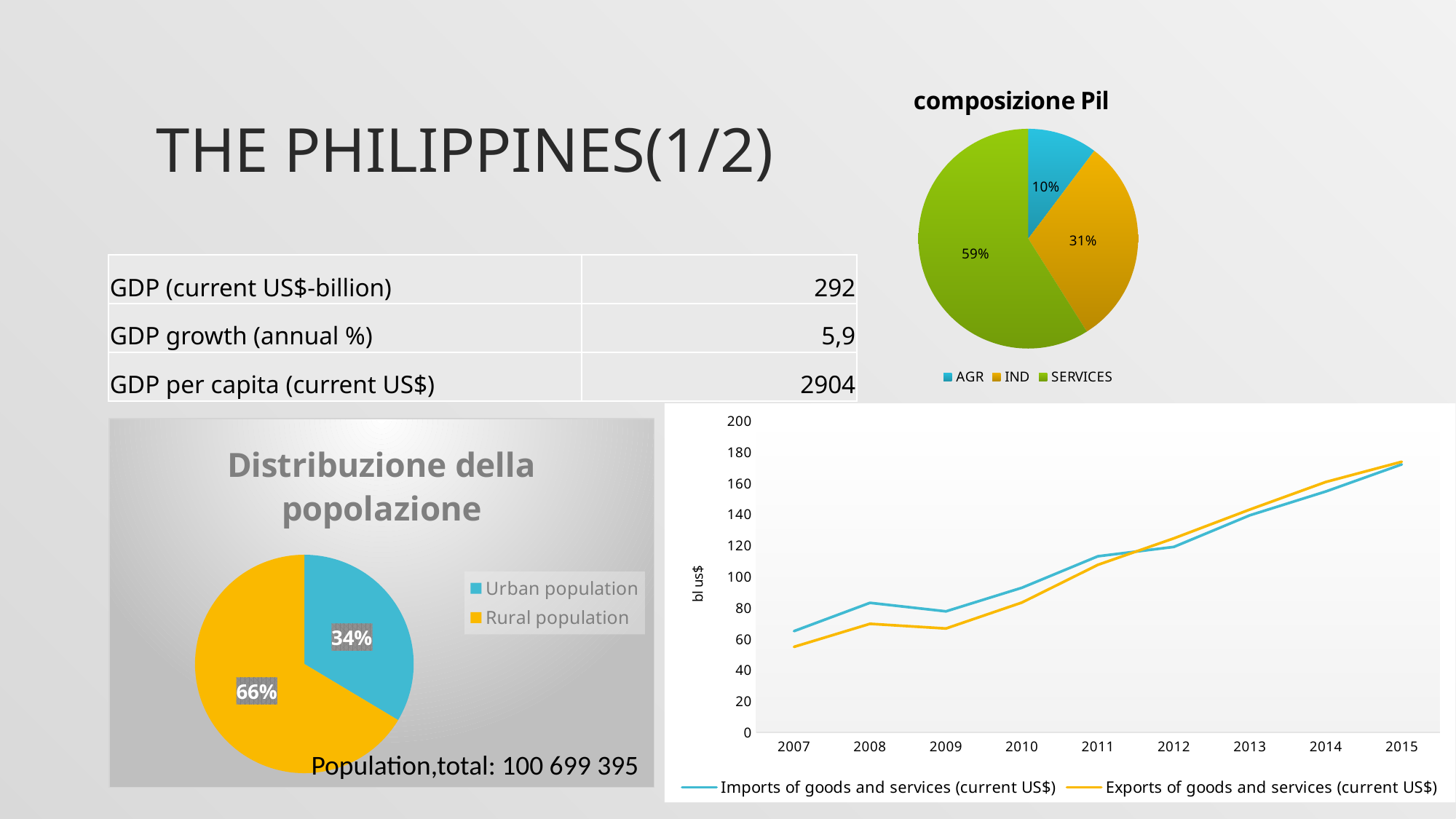
What kind of chart is the chart at the bottom right of the slide showing imports and exports? Line chart How many slices does the 'composizione Pil' pie chart have? 3 In the 'composizione Pil' pie chart, what is the difference in percentage points between the SERVICES and IND shares? 28 In the 'Distribuzione della popolazione' pie chart, what share is Rural population? 66% In the bottom-right line chart, do the Exports of goods and services generally rise or fall from 2009 to 2015? Rise In the 'Distribuzione della popolazione' pie chart, what is the difference in percentage points between Rural and Urban population? 32 In the 'composizione Pil' pie chart, which sector has the smallest share? AGR How many series does the legend of the bottom-right line chart list? 2 In the 'composizione Pil' pie chart, what share does SERVICES have? 59% In the 'composizione Pil' pie chart, what share does IND have? 31% In the 'Distribuzione della popolazione' pie chart, which is larger, Urban population or Rural population? Rural population In the bottom-right line chart, is the value for Imports of goods and services in 2015 greater or less than 160? greater